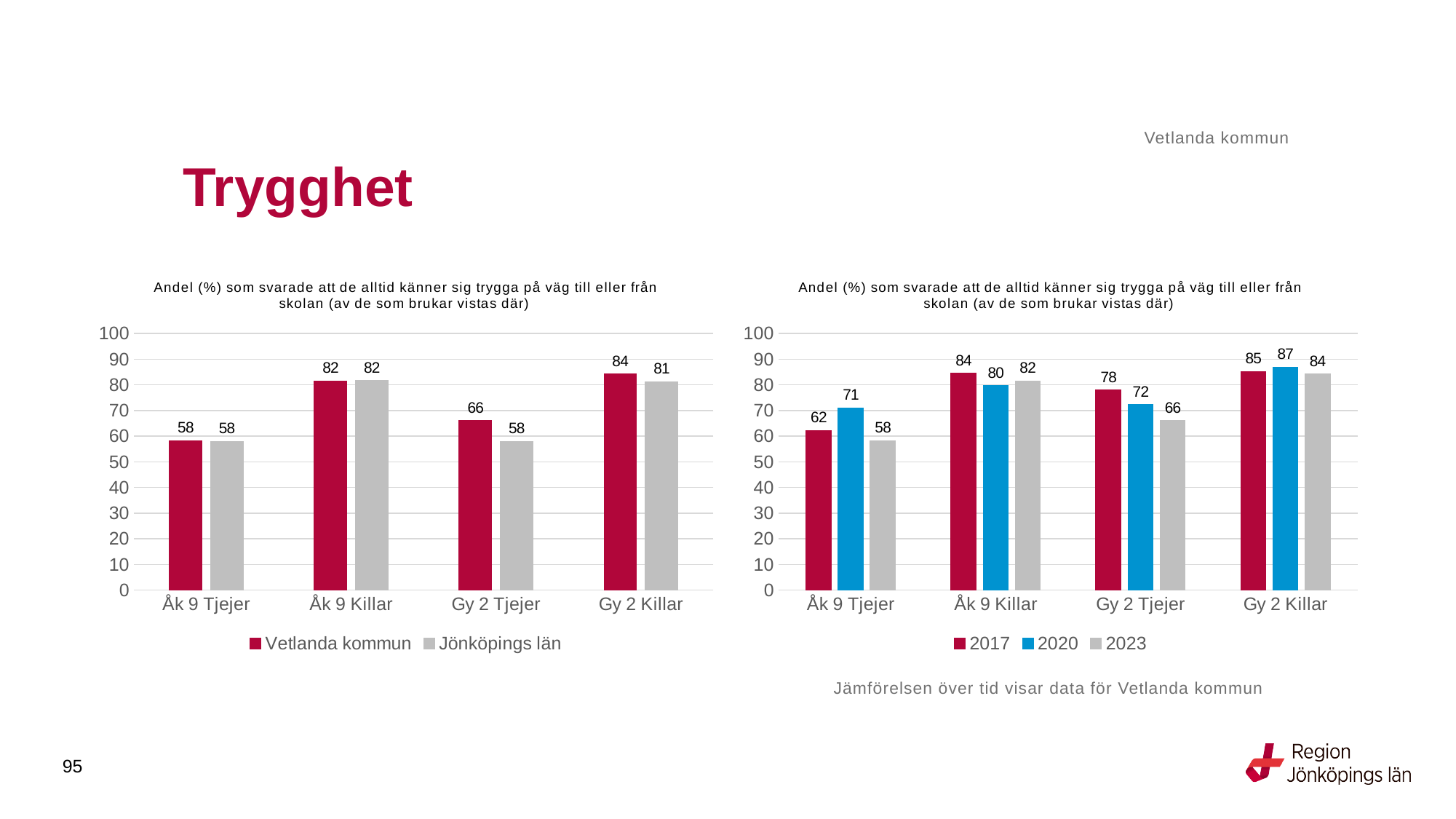
In the right chart, what is the value for 2017 for Gy 2 Tjejer? 78 In the right chart, which is larger for Åk 9 Killar: the 2017 value or the 2020 value? 2017 In the right chart, how many categories are shown on the x axis? 4 In the right chart, what is the difference between the 2020 and 2023 values for Åk 9 Tjejer? 13 What type of chart is the right chart? Bar chart In the left chart, what is the value for Vetlanda kommun for Gy 2 Tjejer? 66 In the right chart, what is the value for 2020 for Åk 9 Tjejer? 71 In the left chart, how many series does the legend list? 2 In the left chart, what is the difference between Vetlanda kommun and Jönköpings län for Gy 2 Tjejer? 8 In the left chart, which category has the highest value for Vetlanda kommun? Gy 2 Killar In the left chart, what is the value for Jönköpings län for Gy 2 Killar? 81 In the right chart, which category has the lowest value for 2023? Åk 9 Tjejer